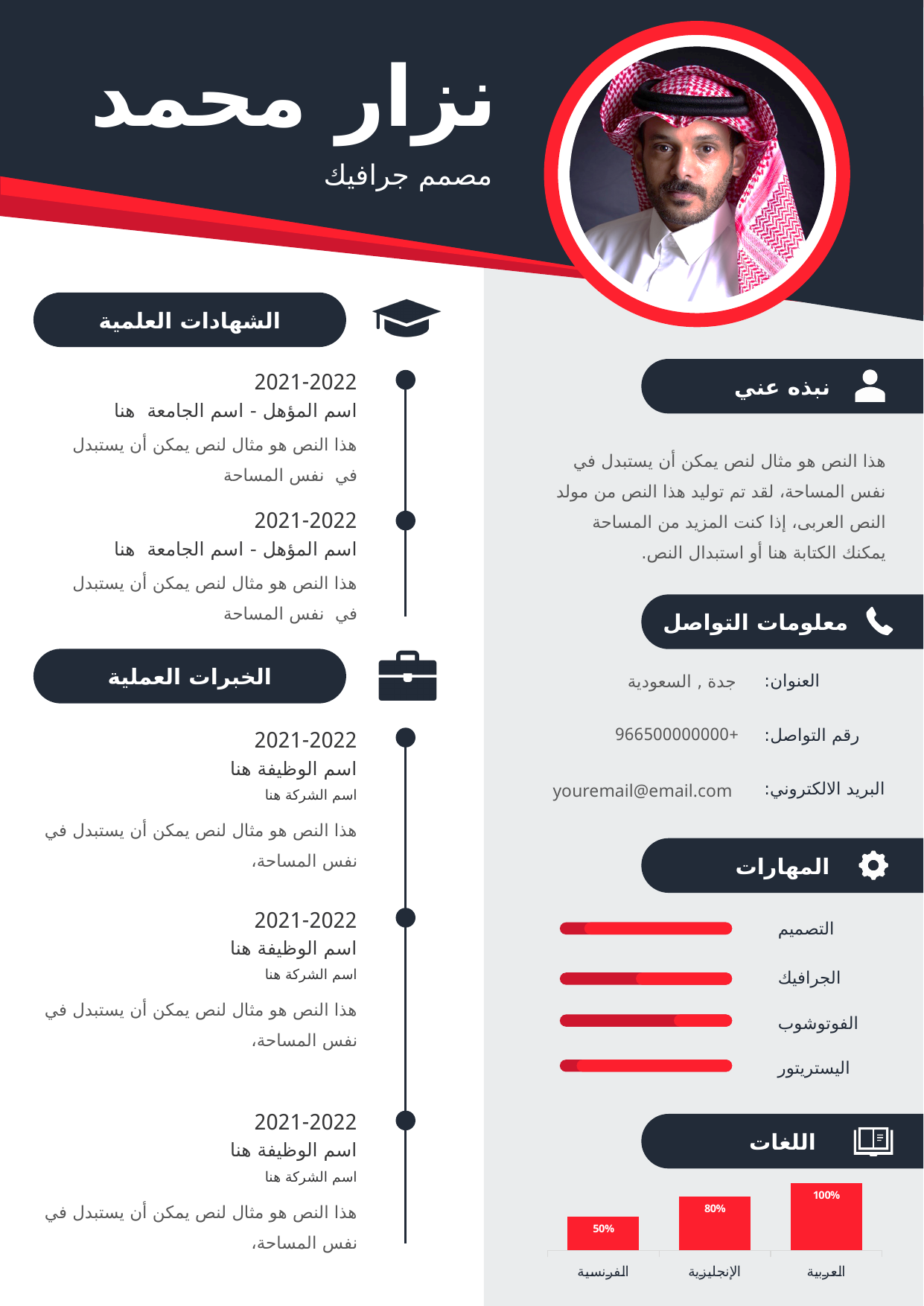
In the languages chart (اللغات), what is the value for الإنجليزية (English)? 80% In the languages chart (اللغات), what is the value for الفرنسية (French)? 50% In the languages chart (اللغات), what is the difference between the values for العربية and الفرنسية? 50% What is the heading above the languages bar chart? اللغات In the languages chart (اللغات), which language has the highest value? العربية In the languages chart (اللغات), what is the difference between the values for الإنجليزية and الفرنسية? 30% In the languages chart (اللغات), which is larger, the value for الإنجليزية or the value for الفرنسية? الإنجليزية In the languages chart (اللغات), what is the value for العربية (Arabic)? 100% What colour are the bars in the languages chart (اللغات)? red How many languages are shown in the languages chart (اللغات)? 3 What kind of chart is the languages chart (اللغات)? bar chart In the languages chart (اللغات), which language has the lowest value? الفرنسية